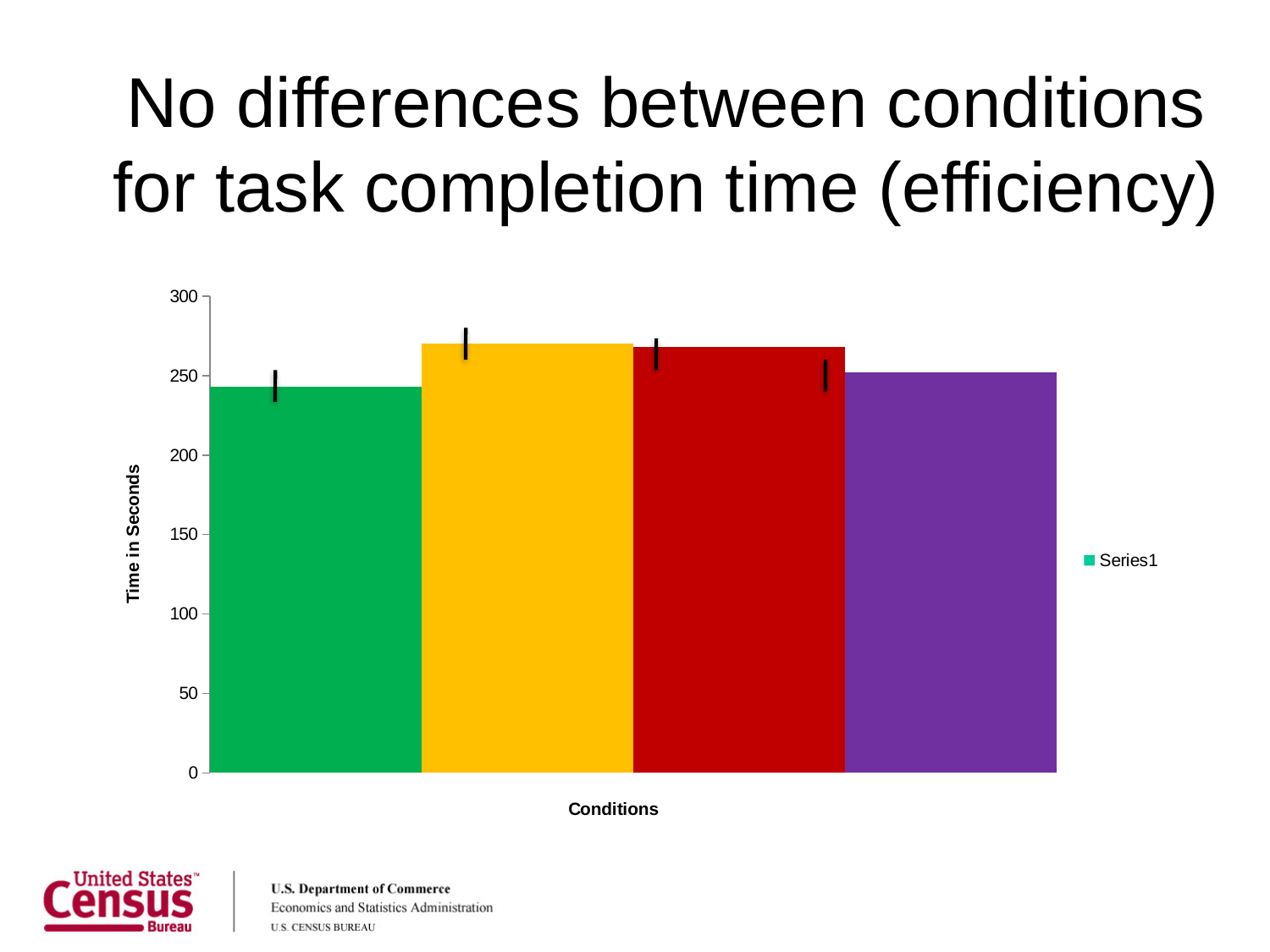
Is the value of the green bar (first from the left) greater or less than 250? less Which bar has the lowest value? the green bar (first from the left) What kind of chart is shown on the slide? bar chart Which is larger, the green bar or the yellow bar? the yellow bar Is the value of the yellow bar (second from the left) greater or less than 250? greater Is the value of the red bar (third from the left) greater or less than 250? greater How many series does the legend list? 1 What is the title of the horizontal axis? Conditions Which is larger, the purple bar or the red bar? the red bar What is the title of the vertical axis? Time in Seconds How many bars are plotted in the chart? 4